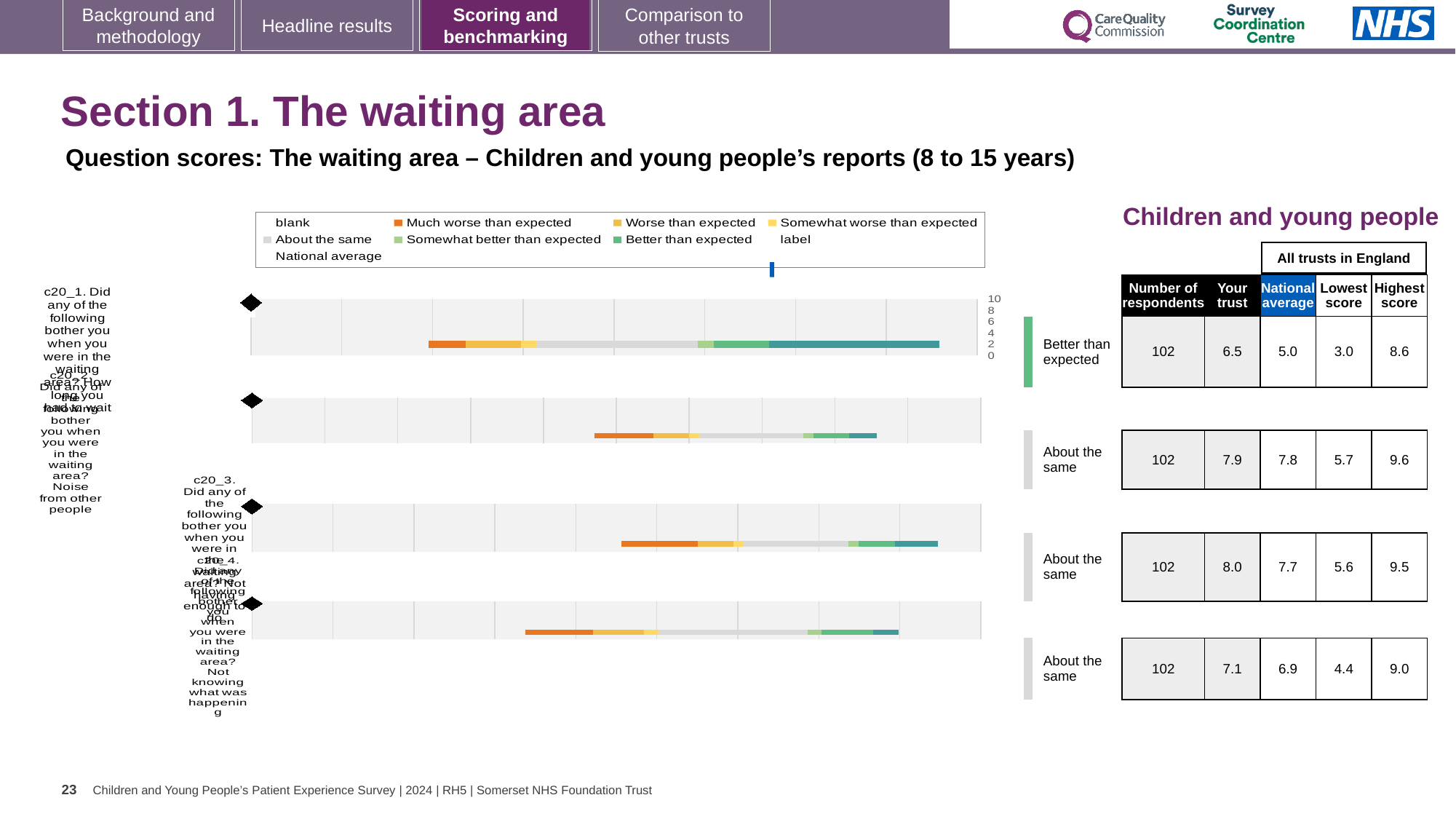
What is the difference between the 'Your trust' score and the national average for the first question (c20_1)? 1.5 In the table, what is the lowest score for the fourth question (c20_4, not knowing what was happening)? 4.4 What kind of chart is shown on the slide? bar chart Which legend entry is shown in orange? Much worse than expected In the table, how many respondents are listed for the third question (c20_3, not having enough to do)? 102 Which legend entry is shown in dark teal? Better than expected How many question bars are plotted in the chart? 4 In the table, what is the 'Your trust' score for the first question (c20_1, how long you had to wait)? 6.5 Which benchmark category is the first question (c20_1) rated as in the table? Better than expected Which question has the highest 'Your trust' score in the table? c20_3 (Not having enough to do) In the table, what is the highest score for the second question (c20_2, noise from other people)? 9.6 In the table, what is the national average for the first question (c20_1, how long you had to wait)? 5.0